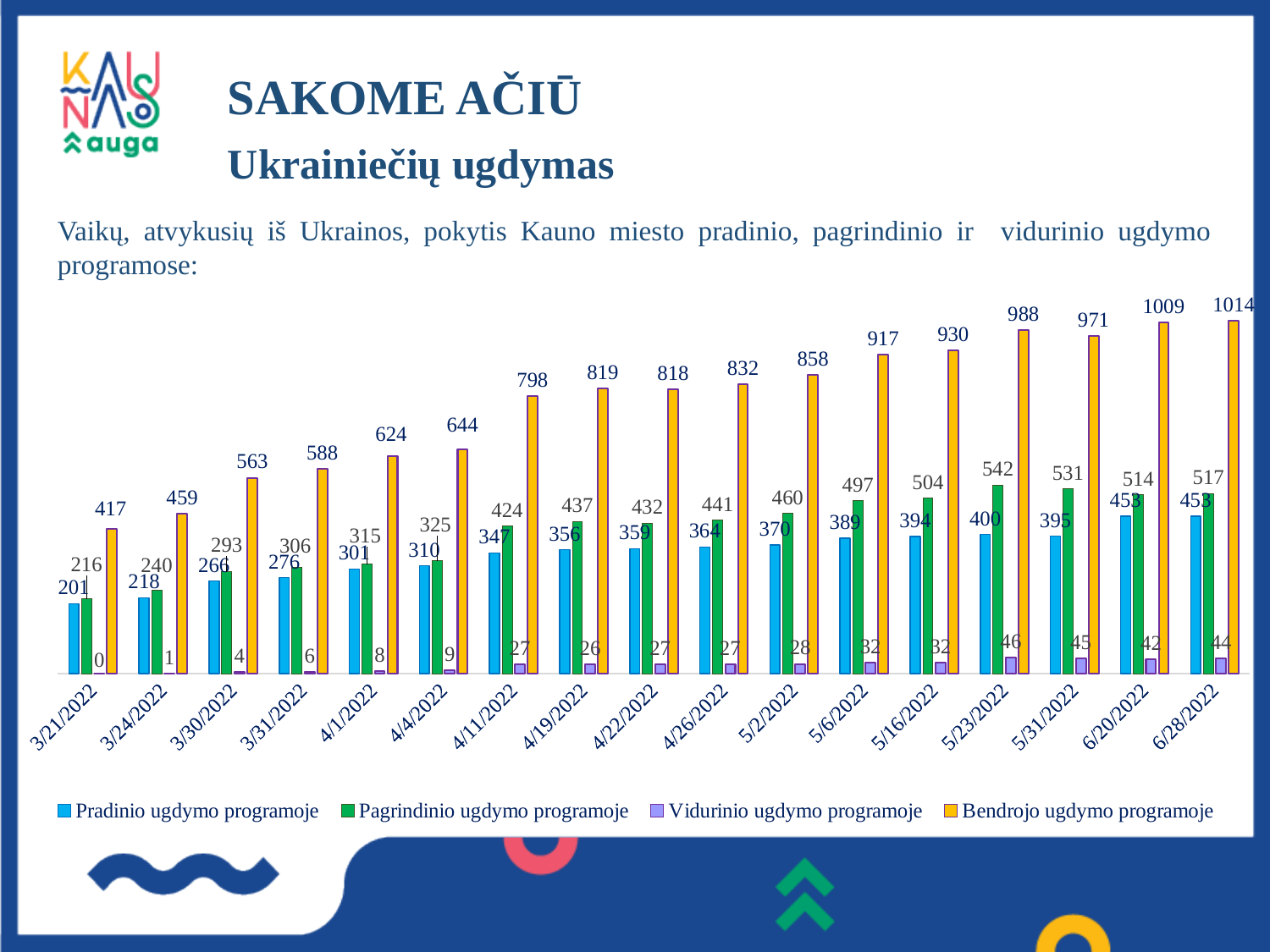
How many series does the legend list? 4 Does the Bendrojo ugdymo programoje value generally rise or fall from 3/21/2022 to 6/28/2022? rise What is the difference between the Bendrojo ugdymo programoje values on 6/28/2022 and 3/21/2022? 597 What is the value for Pagrindinio ugdymo programoje on 5/23/2022? 542 On which date is the Bendrojo ugdymo programoje value highest? 6/28/2022 What is the value for Vidurinio ugdymo programoje on 3/21/2022? 0 Which is larger: the Pagrindinio ugdymo programoje value on 5/23/2022 or on 5/31/2022? 5/23/2022 What is the value for Bendrojo ugdymo programoje on 6/28/2022? 1014 What is the value for Pradinio ugdymo programoje on 4/11/2022? 347 On which date is the Pradinio ugdymo programoje value lowest? 3/21/2022 How many dates are shown on the x axis? 17 What kind of chart is shown on the slide? bar chart